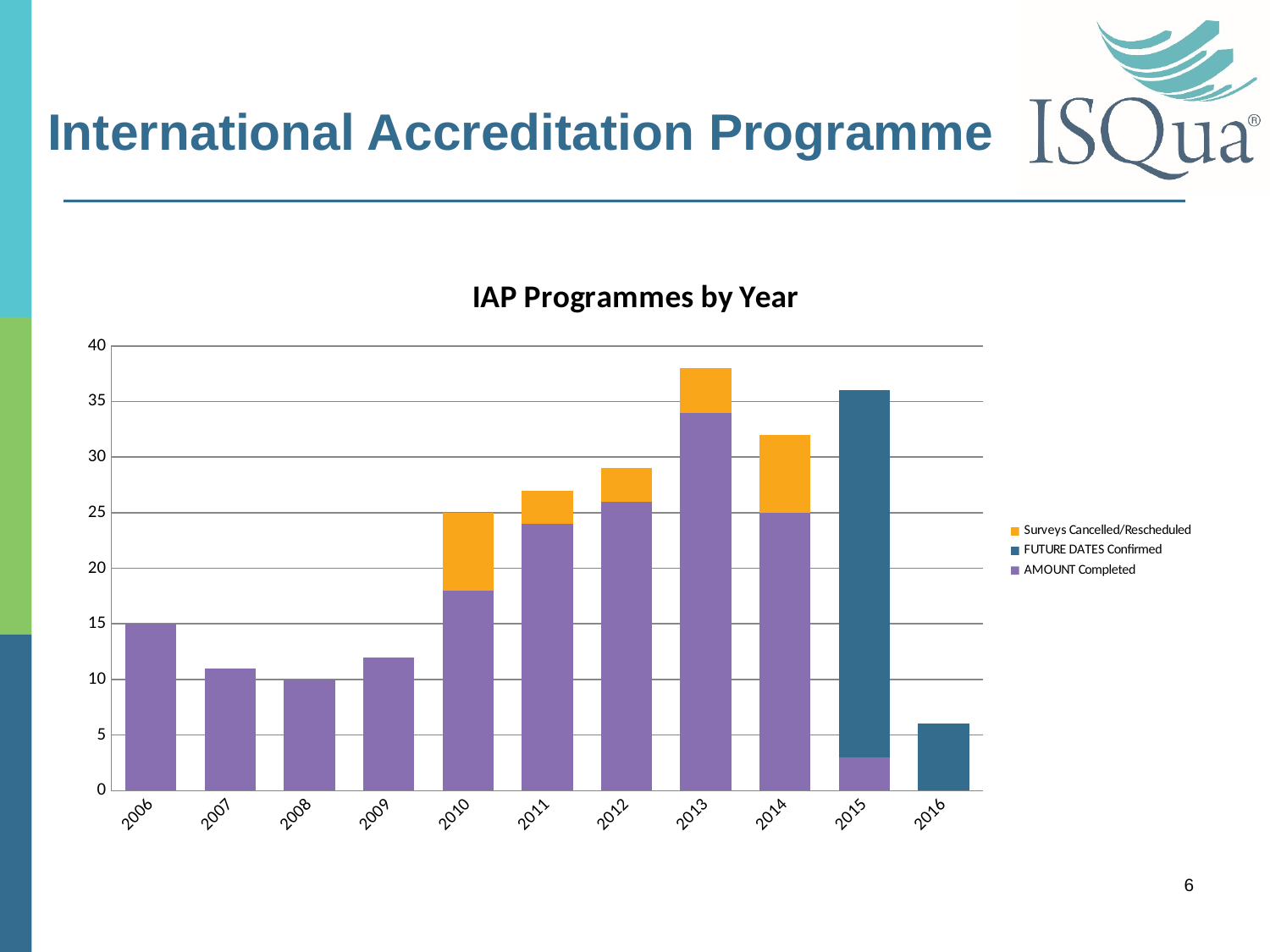
Is the total bar height for 2015 greater or less than 30? greater What is the title of the chart? IAP Programmes by Year What is the value for AMOUNT Completed in 2008? 10 Is the AMOUNT Completed value for 2011 greater or less than 20? greater Do the total bar heights rise or fall from 2008 to 2013? rise Which year has the tallest stacked bar overall? 2013 How many years are shown on the x axis? 11 Which year has the shortest stacked bar overall? 2016 What is the value for AMOUNT Completed in 2006? 15 How many series does the legend list? 3 What kind of chart is shown on the slide? stacked bar chart Which year has a larger AMOUNT Completed value, 2012 or 2009? 2012